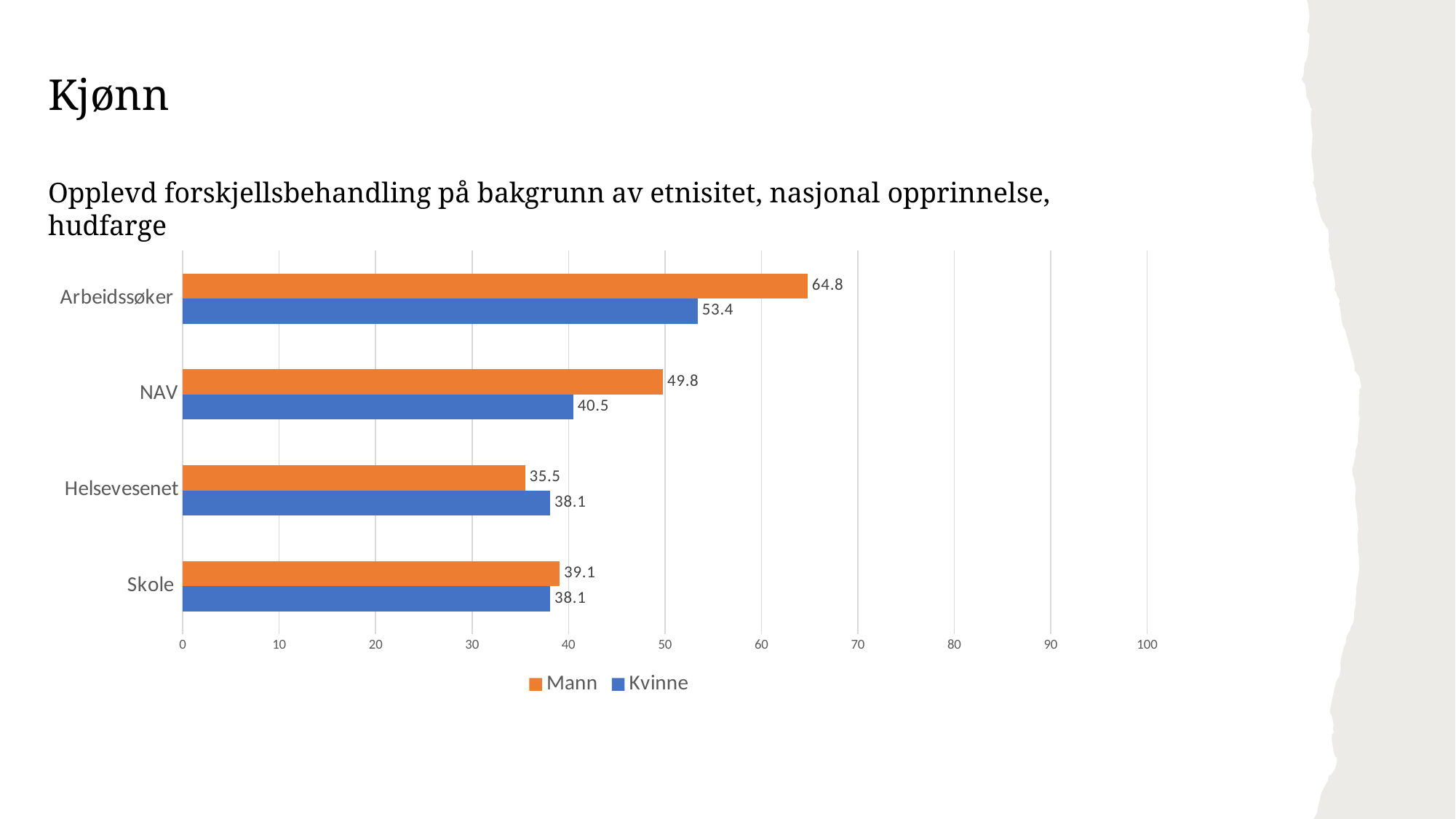
How many categories are shown on the chart? 4 What is the difference between the Mann and Kvinne values for NAV? 9.3 How many series does the legend list? 2 What is the value for Kvinne in the Helsevesenet category? 38.1 For Helsevesenet, which is larger: the Mann value or the Kvinne value? Kvinne What is the value for Mann in the Arbeidssøker category? 64.8 What is the difference between the Mann and Kvinne values for Arbeidssøker? 11.4 What kind of chart is shown on the slide? Bar chart Which category has the highest value for Mann? Arbeidssøker Is the Kvinne value for Arbeidssøker greater or less than 50? greater What is the value for Kvinne in the NAV category? 40.5 Which category has the lowest value for Mann? Helsevesenet